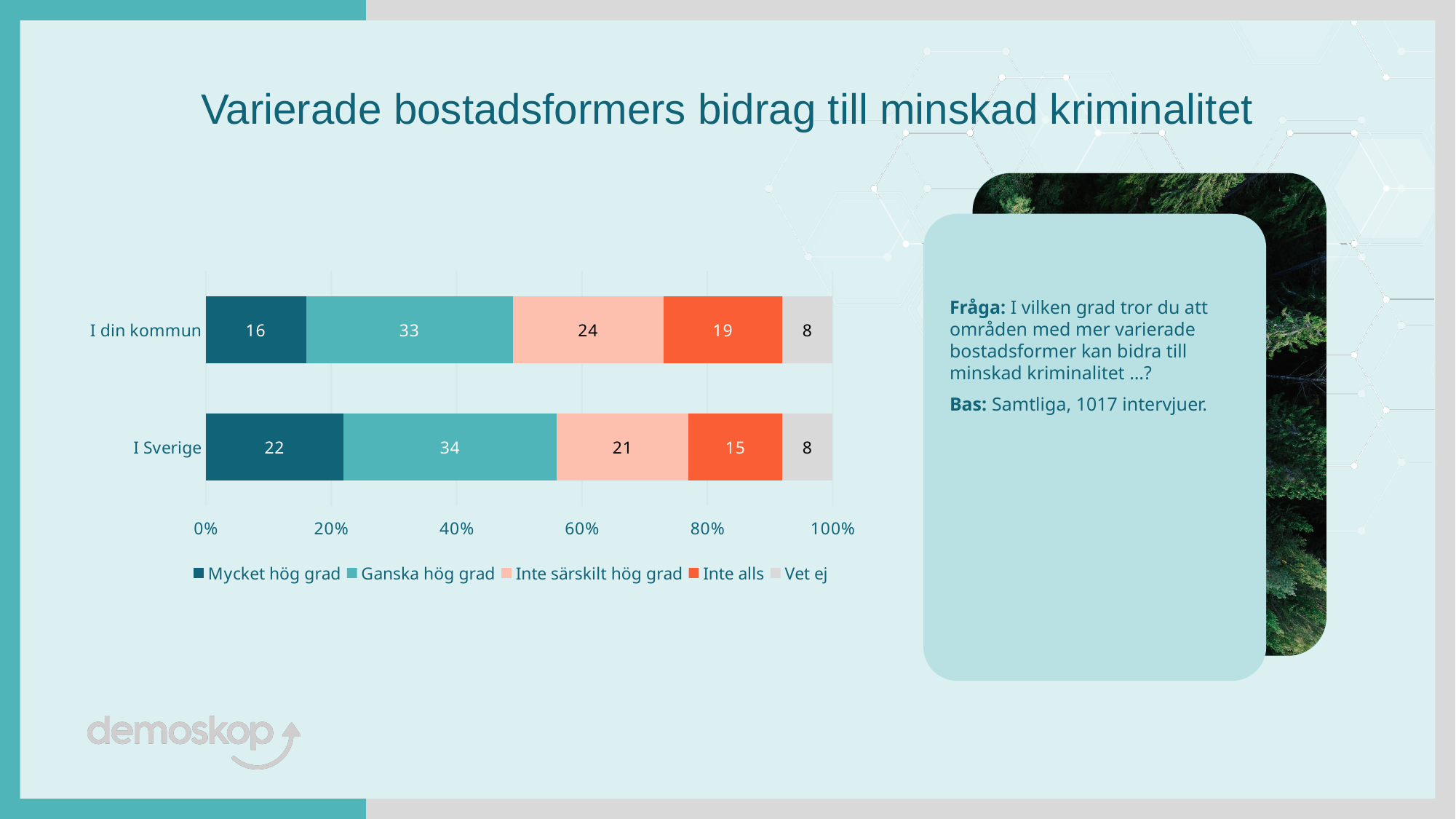
What kind of chart is shown on the slide? Stacked bar chart What is the value for "Inte alls" in the "I din kommun" bar? 19 Which category has the higher value for "Inte alls", "I din kommun" or "I Sverige"? I din kommun What is the total of all segments in the "I din kommun" bar? 100 How many series does the legend list? 5 What is the value for "Mycket hög grad" in the "I din kommun" bar? 16 Which category has the higher value for "Mycket hög grad", "I din kommun" or "I Sverige"? I Sverige What is the difference between the "Mycket hög grad" values for "I Sverige" and "I din kommun"? 6 What is the value for "Ganska hög grad" in the "I Sverige" bar? 34 What is the value for "Vet ej" in the "I Sverige" bar? 8 How many categories are shown on the chart? 2 What is the difference between the "Inte särskilt hög grad" values for "I din kommun" and "I Sverige"? 3